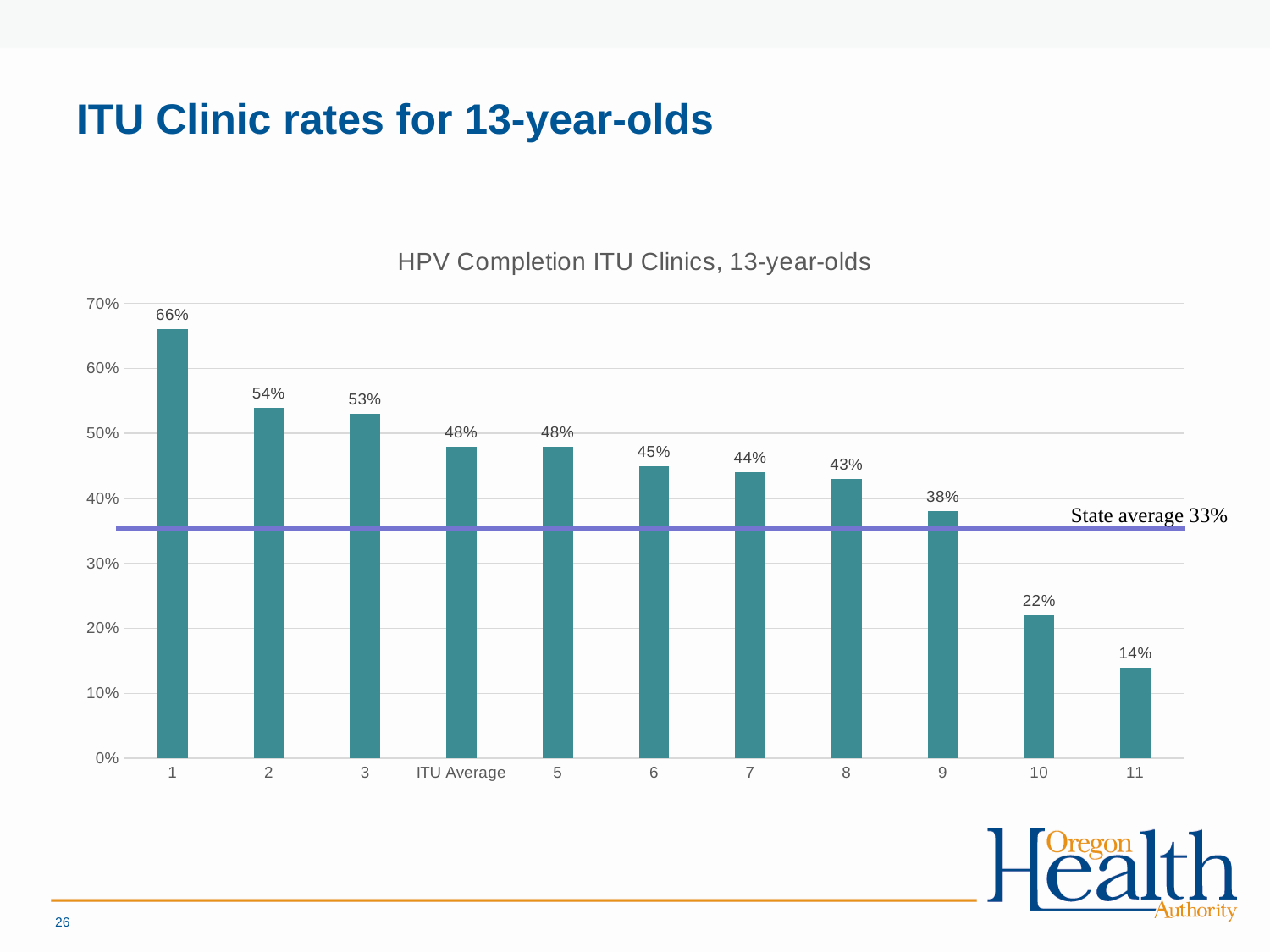
Which is larger, the value for clinic 9 or the value for clinic 10? 9 What is the difference between the values for clinic 1 and clinic 11? 52% Which category has the lowest value? 11 Which category has the highest value? 1 What is the value for clinic 11? 14% What is the value for clinic 1? 66% How many bars are plotted in the chart? 11 What is the state average shown by the horizontal line? 33% What is the value for ITU Average? 48% Is the value for clinic 8 greater or less than 40%? greater What kind of chart is shown? bar chart What is the difference between the values for clinic 2 and clinic 3? 1%